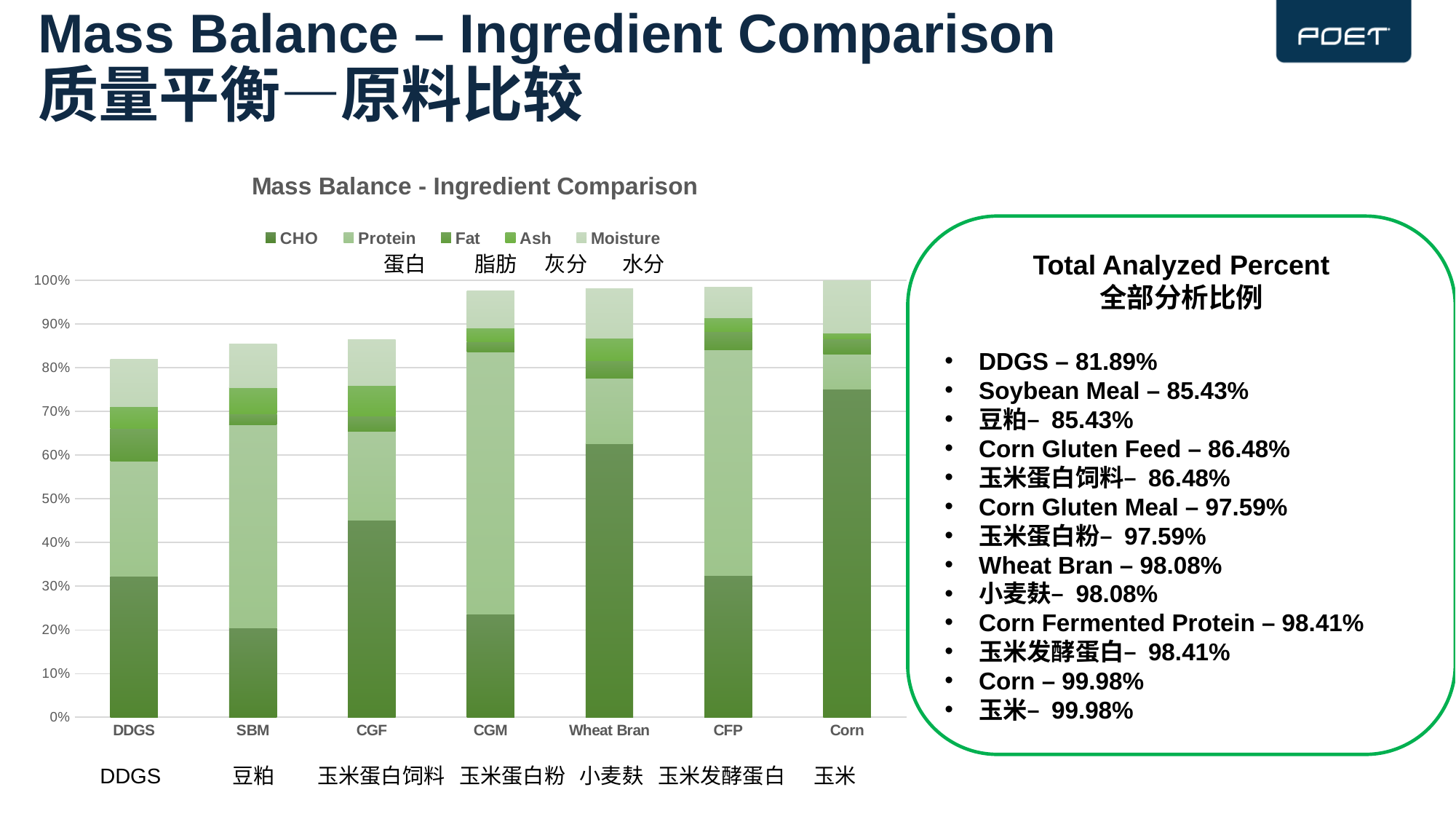
According to the slide, what is the total analyzed percent for the DDGS stacked bar? 81.89% How many series does the chart legend list? 5 Which ingredient has the largest CHO segment in the chart? Corn Which ingredient has the shortest stacked bar in the chart? DDGS Is the CHO value for CGF greater or less than 40%? greater What is the title of the chart? Mass Balance - Ingredient Comparison Is the CHO value for DDGS greater or less than 30%? greater What kind of chart is shown on the slide? stacked bar chart How many ingredient categories are shown on the x axis of the chart? 7 Which ingredient has the tallest stacked bar in the chart? Corn Which has the larger CHO segment, Wheat Bran or CGM? Wheat Bran Is the CHO value for Wheat Bran greater or less than 60%? greater